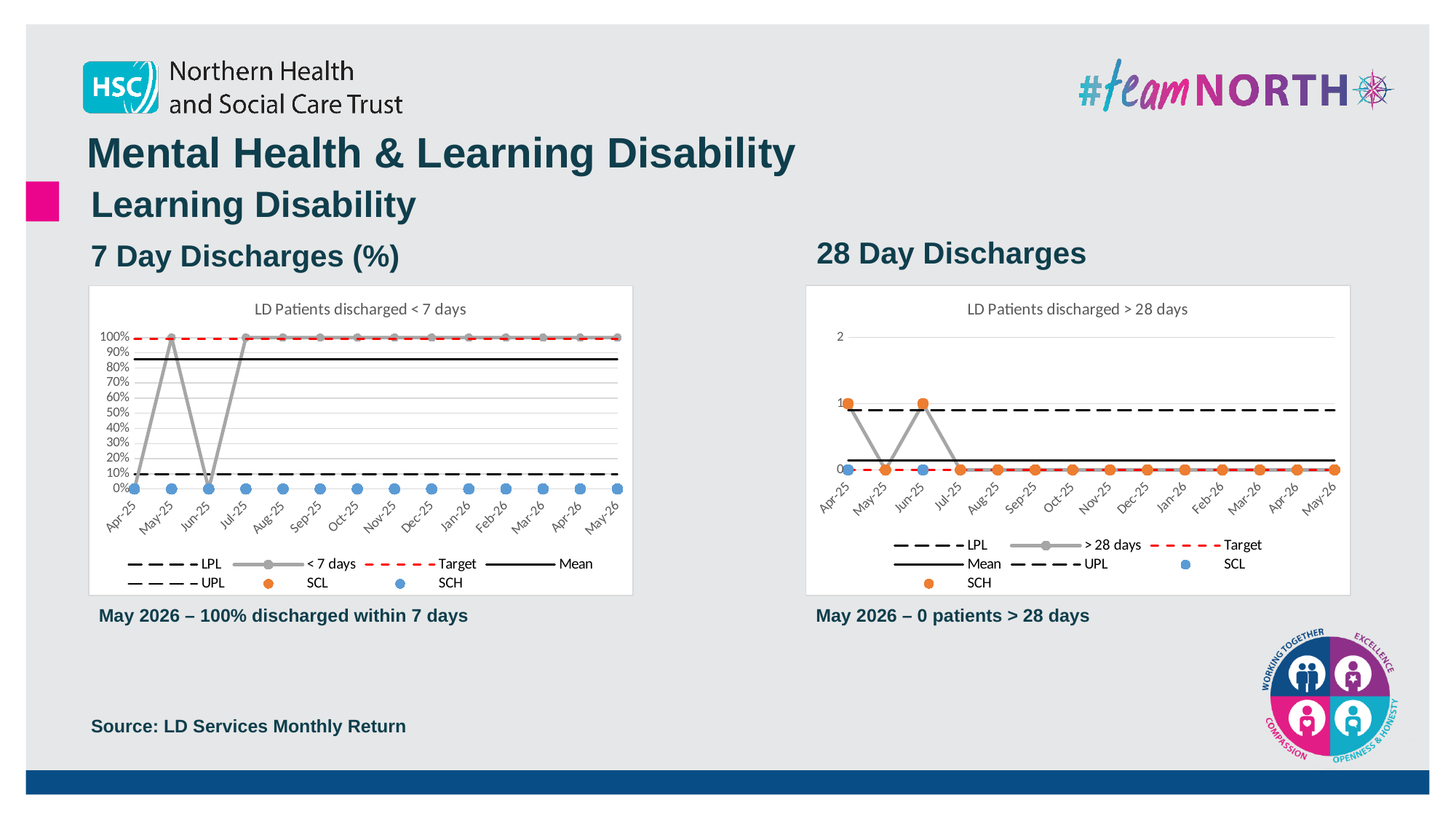
What kind of chart is the 'LD Patients discharged < 7 days' chart? line chart In the 'LD Patients discharged < 7 days' chart, is the Mean line greater or less than 80%? greater What colour is the Target line in the 'LD Patients discharged < 7 days' chart? red How many series does the legend of the 'LD Patients discharged < 7 days' chart list? 7 In the 'LD Patients discharged > 28 days' chart, what is the difference between the values for Apr-25 and May-25? 1 In the 'LD Patients discharged < 7 days' chart, what is the value for May-26? 100% In the 'LD Patients discharged > 28 days' chart, what is the value for May-26? 0 In the 'LD Patients discharged < 7 days' chart, what is the value for Apr-25? 0% In the 'LD Patients discharged < 7 days' chart, which is larger, the value for May-25 or the value for Jun-25? May-25 In the 'LD Patients discharged > 28 days' chart, what is the value for Apr-25? 1 How many series does the legend of the 'LD Patients discharged > 28 days' chart list? 7 How many months are plotted on the x axis of the 'LD Patients discharged < 7 days' chart? 14